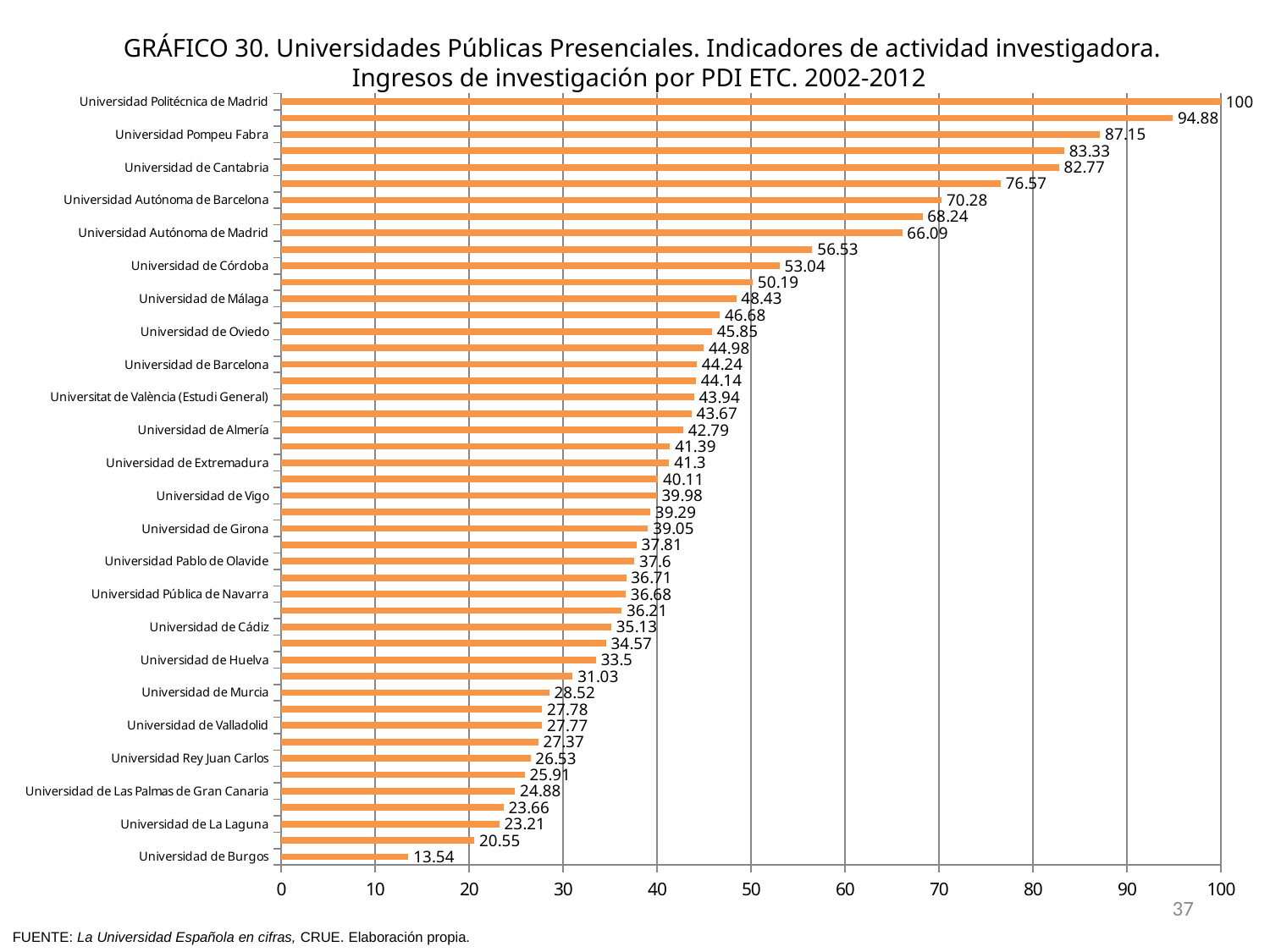
Which university has the lowest value? Universidad de Burgos Which is larger, the value for Universidad de Málaga or Universidad de Oviedo? Universidad de Málaga Do the values rise or fall going from the top bar to the bottom bar? Fall What type of chart is shown on the slide? Bar chart What is the maximum value shown on the horizontal axis? 100 What is the value for Universidad de Burgos? 13.54 Which university has the highest value? Universidad Politécnica de Madrid What is the value for Universidad de Cantabria? 82.77 Is the value for Universidad de Huelva greater or less than 40? less What is the value for Universidad Politécnica de Madrid? 100 What is the value for Universidad de Córdoba? 53.04 What is the difference between the values for Universidad Pompeu Fabra and Universidad Autónoma de Madrid? 21.06